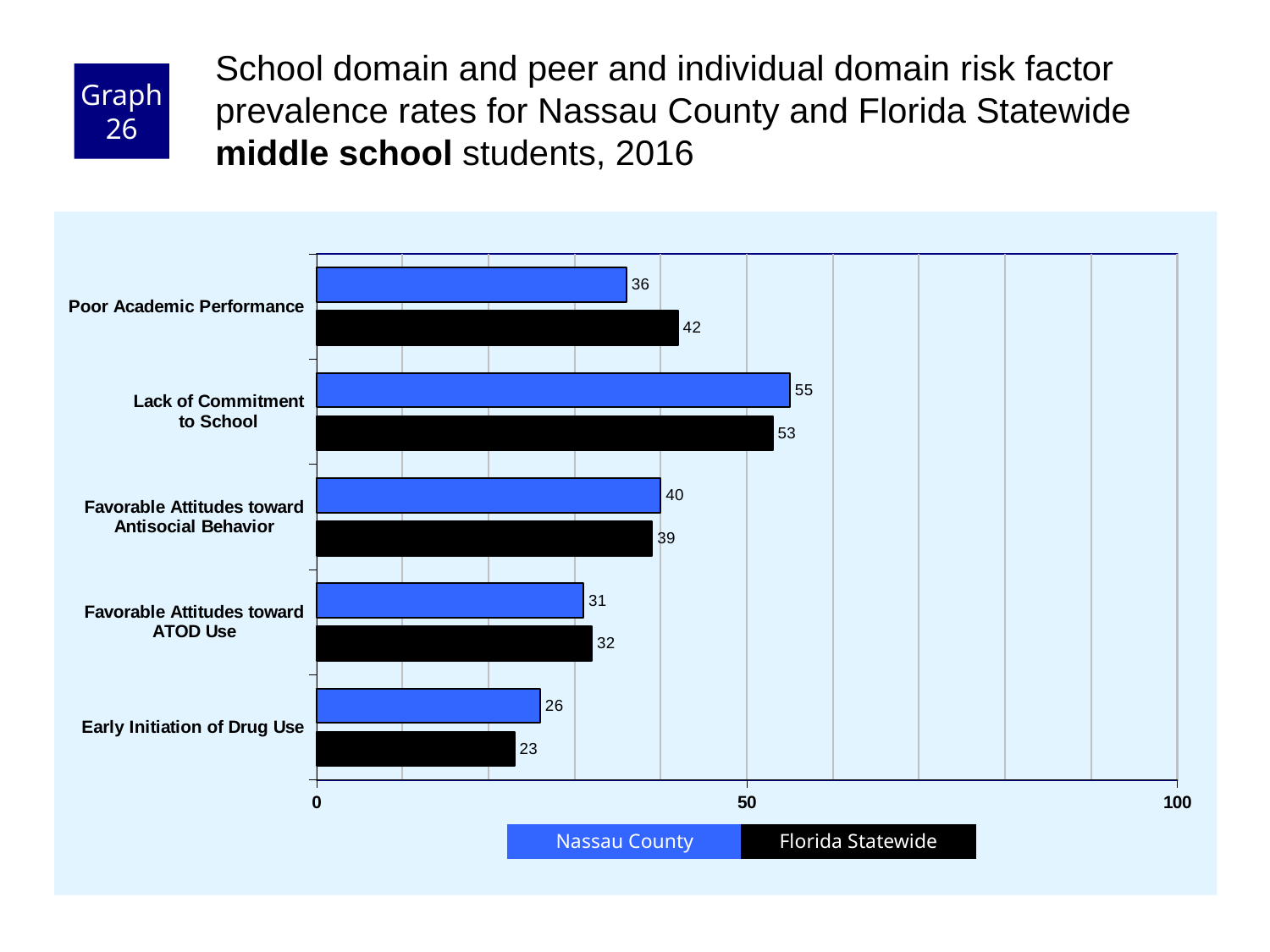
Which risk factor has the highest Nassau County value? Lack of Commitment to School How many risk factors are shown on the chart? 5 What is the Florida Statewide value for Lack of Commitment to School? 53 Which risk factor has the lowest Florida Statewide value? Early Initiation of Drug Use For Early Initiation of Drug Use, which is larger: the Nassau County value or the Florida Statewide value? Nassau County Is the Nassau County value for Lack of Commitment to School greater or less than 50? greater What is the difference between the Florida Statewide and Nassau County values for Poor Academic Performance? 6 How many series does the legend list? 2 What kind of chart is shown on the slide? bar chart Which colour represents Florida Statewide in the chart? black What is the Nassau County value for Poor Academic Performance? 36 What is the Florida Statewide value for Early Initiation of Drug Use? 23